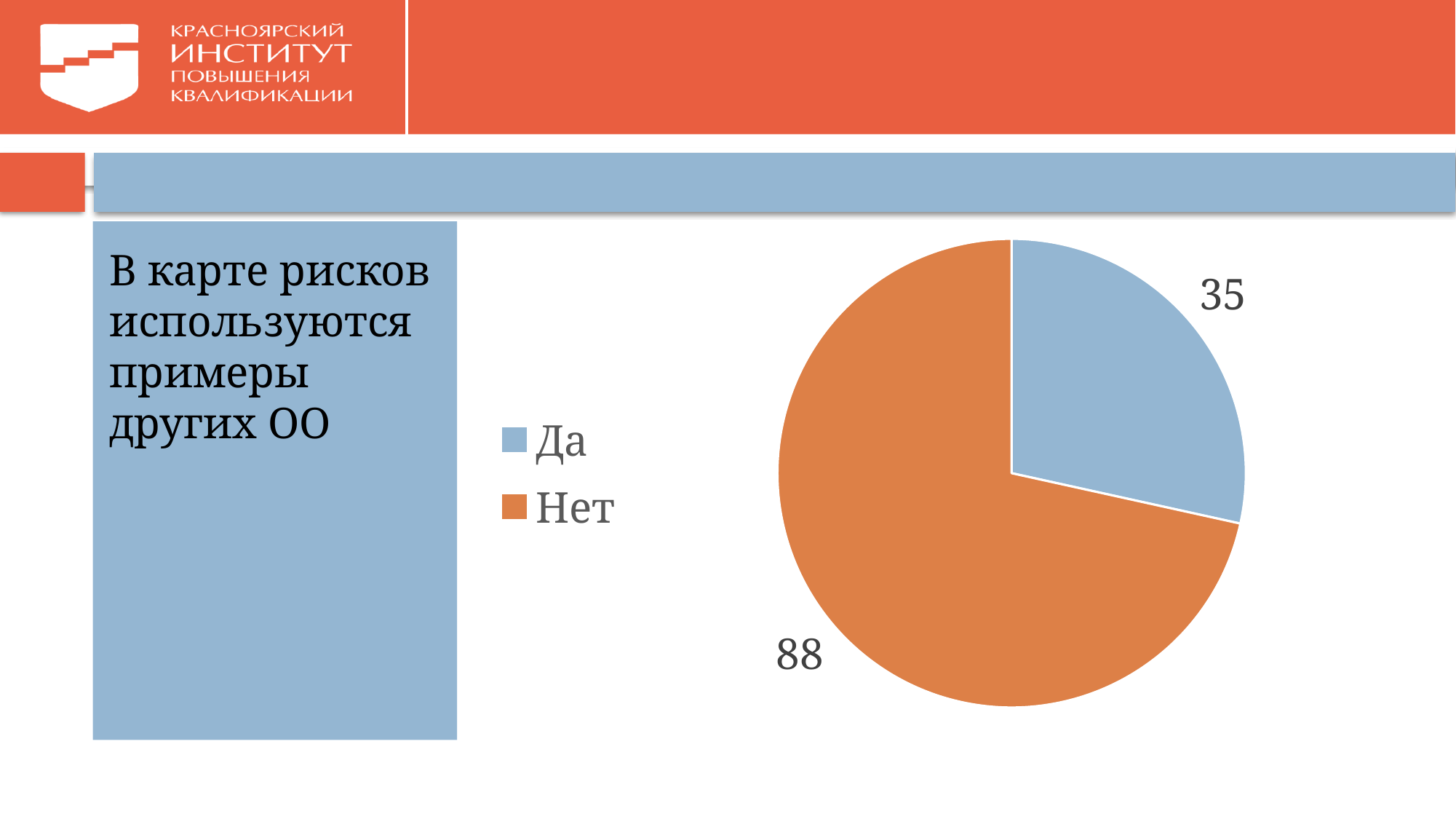
What colour is the "Нет" slice? orange How many entries does the legend list? 2 What colour is the "Да" slice? blue What is the total of the two slice values? 123 What is the value for "Нет"? 88 What is the value for "Да"? 35 Which category has the smallest slice? Да What kind of chart is shown on the slide? pie chart What is the difference between the values for "Нет" and "Да"? 53 Which is larger, the value for "Да" or the value for "Нет"? Нет How many slices does the pie chart have? 2 Which category has the largest slice? Нет